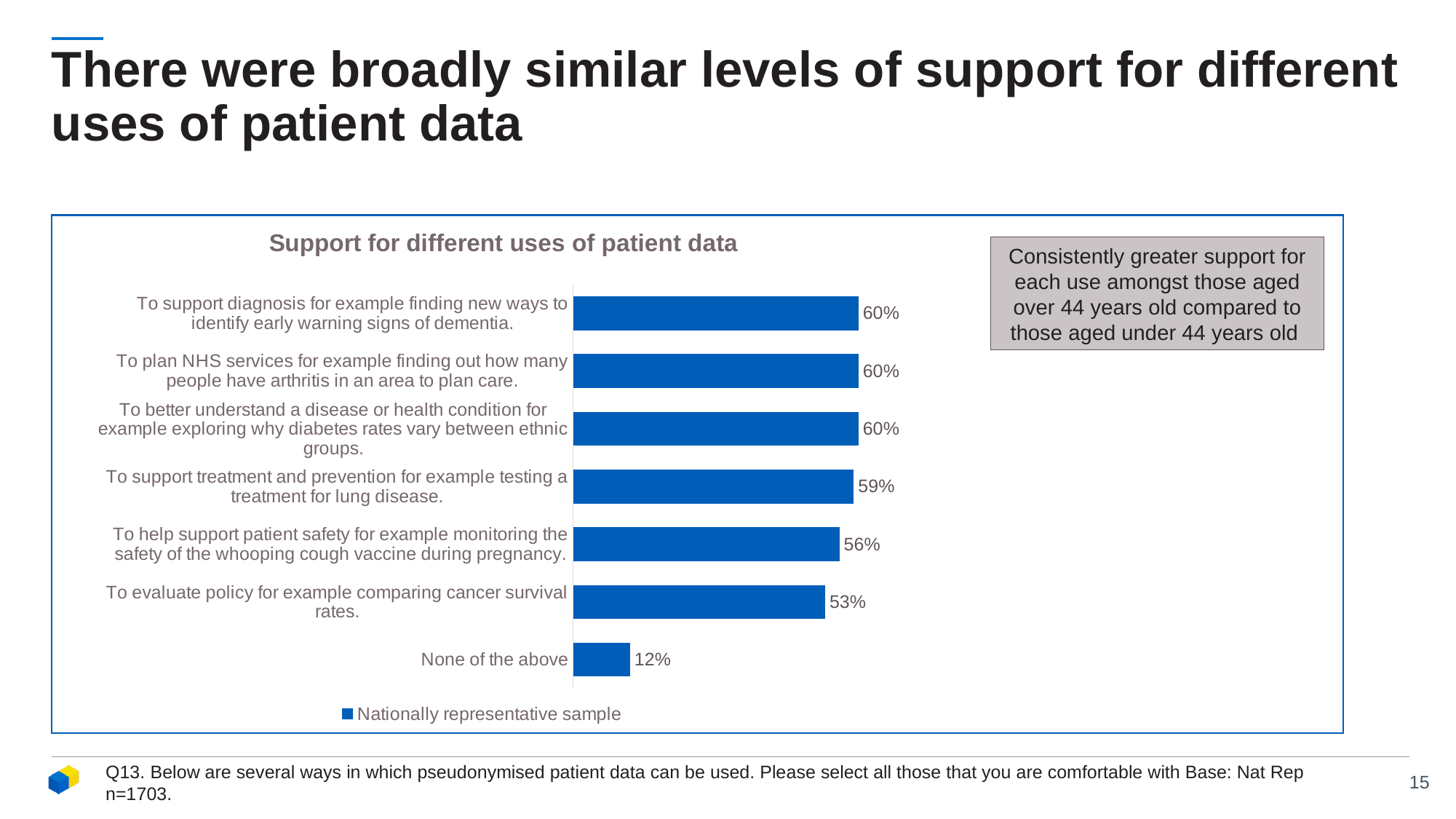
What is the difference between the value for 'To help support patient safety' and the value for 'None of the above'? 44 percentage points Which is larger: the value for 'To help support patient safety' or the value for 'To evaluate policy'? To help support patient safety Which category has the lowest value in the chart? None of the above How many categories are shown in the chart? 7 What is the difference between the value for 'To support treatment and prevention' and the value for 'To evaluate policy'? 6 percentage points What is the value for 'To help support patient safety for example monitoring the safety of the whooping cough vaccine during pregnancy'? 56% What type of chart is shown on the slide? Bar chart What percentage of respondents supported using patient data to evaluate policy, for example comparing cancer survival rates? 53% What percentage of respondents selected 'None of the above'? 12% What is the value for 'To support treatment and prevention for example testing a treatment for lung disease'? 59% What is the title of the chart? Support for different uses of patient data How many series does the legend list? 1